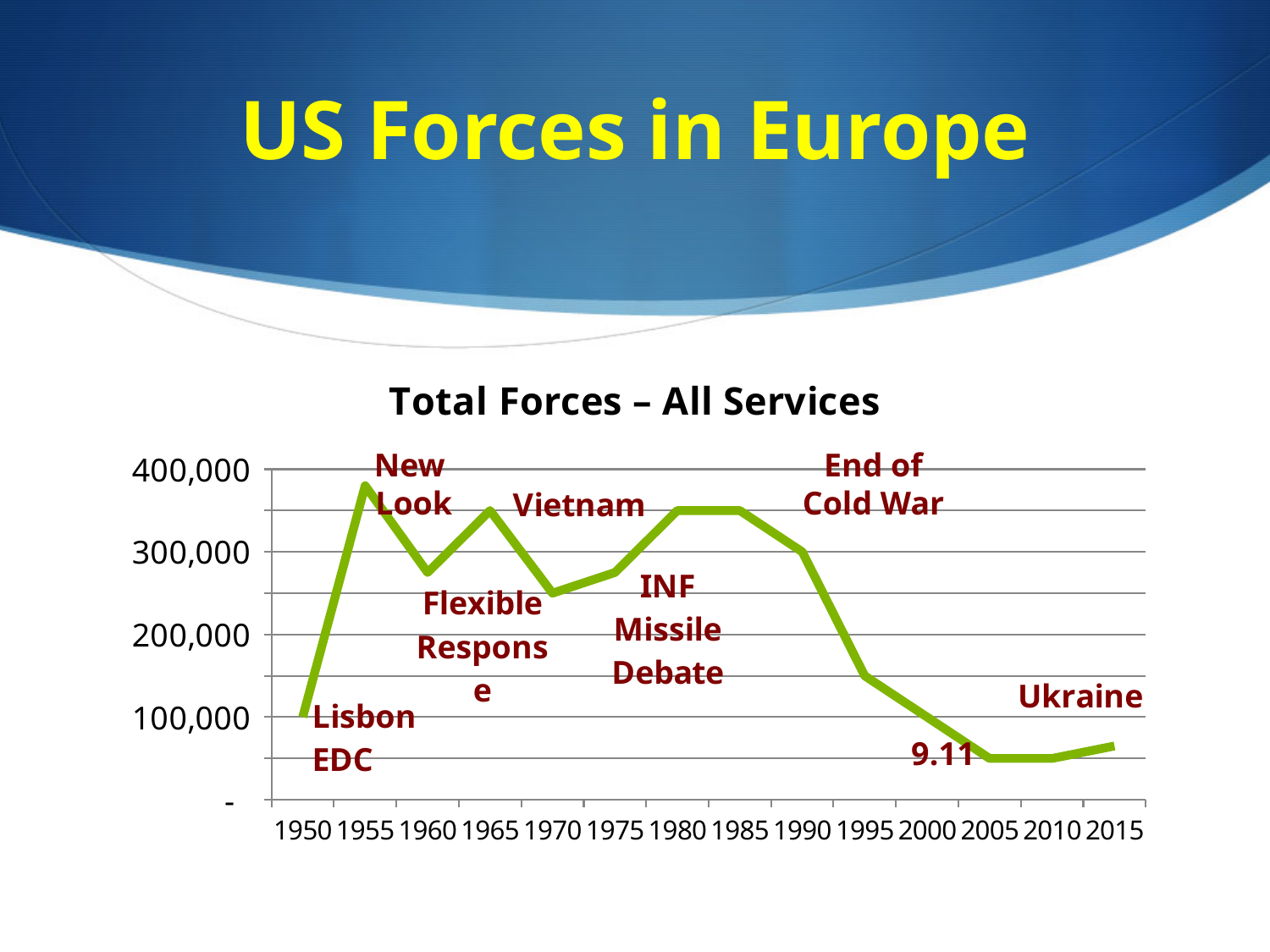
What is the title of the chart? Total Forces – All Services Which event label is placed near the 2015 end of the line? Ukraine Do the values rise or fall between 1990 and 2005? fall Is the value for 2005 greater or less than 100,000? less What kind of chart is shown on the slide? line chart Is the value for 1955 greater or less than 300,000? greater Is the value for 1970 greater or less than 300,000? less Which is larger, the value for 1990 or the value for 2000? 1990 Which year has the highest value on the chart? 1955 How many years are labelled along the x axis of the chart? 14